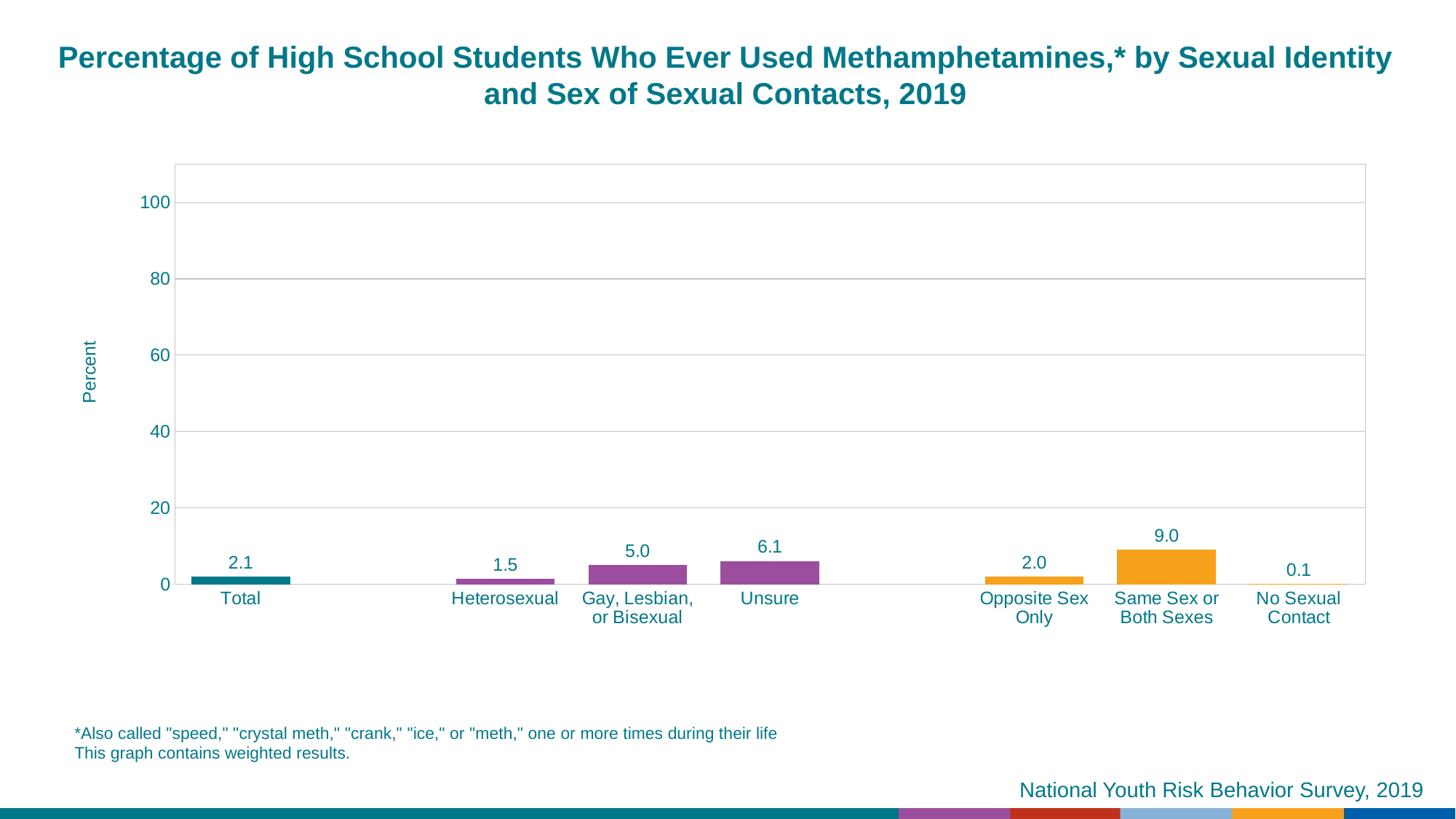
What is the value for Gay, Lesbian, or Bisexual students? 5.0 What is the difference between the values for Unsure and Heterosexual? 4.6 Which category has the highest value? Same Sex or Both Sexes Which is larger, the value for Opposite Sex Only or the value for Same Sex or Both Sexes? Same Sex or Both Sexes What kind of chart is this? bar chart How many categories are shown on the x axis? 7 What is the value for Heterosexual students? 1.5 What is the value for Total? 2.1 What is the label on the y axis? Percent What is the value for students with No Sexual Contact? 0.1 Which category has the lowest value? No Sexual Contact Is the value for Same Sex or Both Sexes greater or less than 20? less